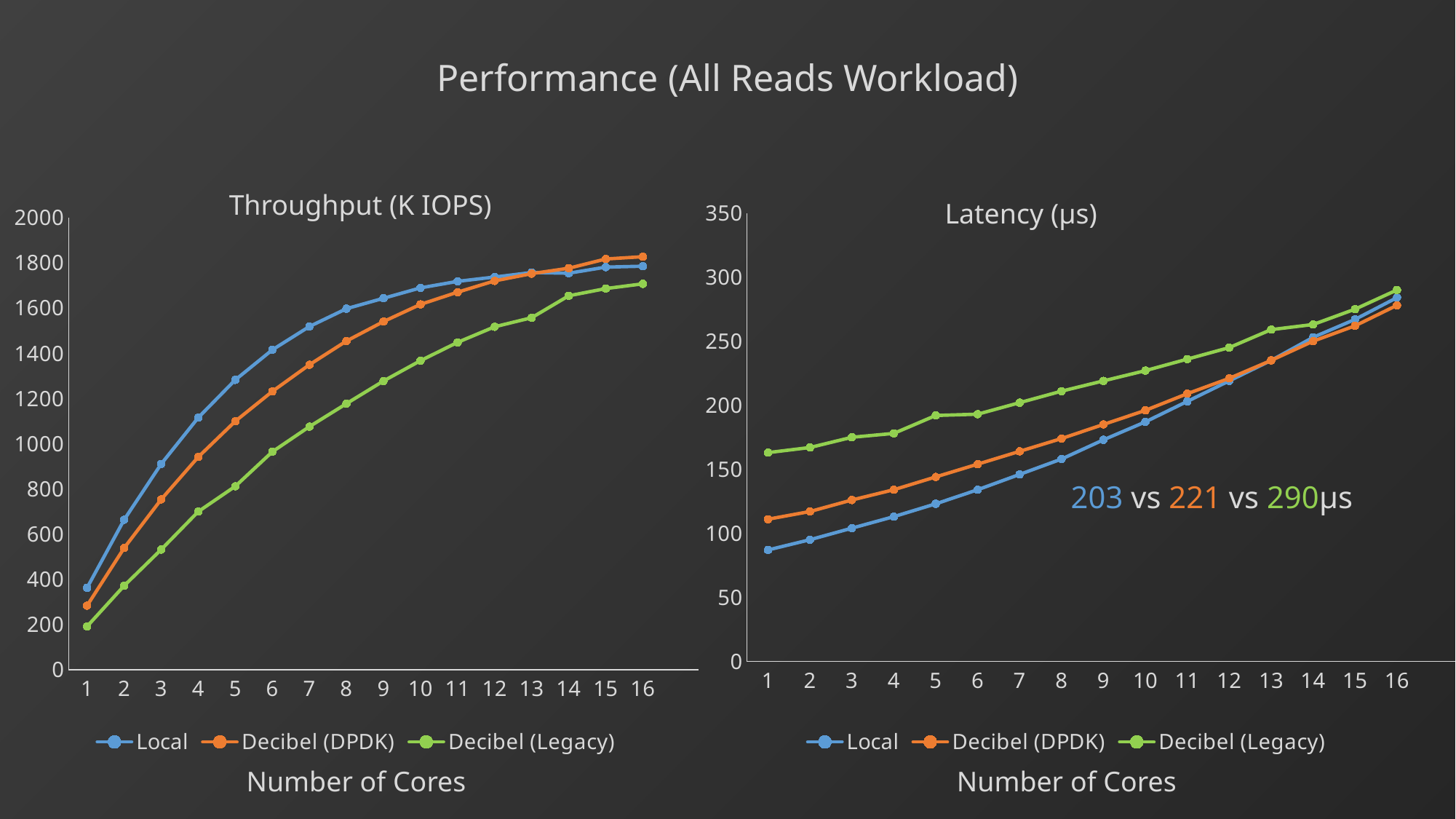
In the Latency (µs) chart, is the value for Local at 1 core greater or less than 100? less In the Latency (µs) chart, which is larger at 1 core: Decibel (Legacy) or Local? Decibel (Legacy) In the Throughput (K IOPS) chart, which series has the lowest value at 16 cores? Decibel (Legacy) In the Throughput (K IOPS) chart, which series has the highest value at 1 core? Local In the Latency (µs) chart, which series has the lowest value at 1 core? Local In the Latency (µs) chart, is the value for Decibel (Legacy) at 16 cores greater or less than 250? greater How many series does the legend of the Latency (µs) chart list? 3 How many core counts are plotted along the x axis of the Throughput (K IOPS) chart? 16 What kind of chart is the Throughput (K IOPS) chart? line chart In the Latency (µs) chart, do the values rise or fall as the number of cores increases? rise In the Throughput (K IOPS) chart, is the value for Local at 7 cores greater or less than 1400? greater